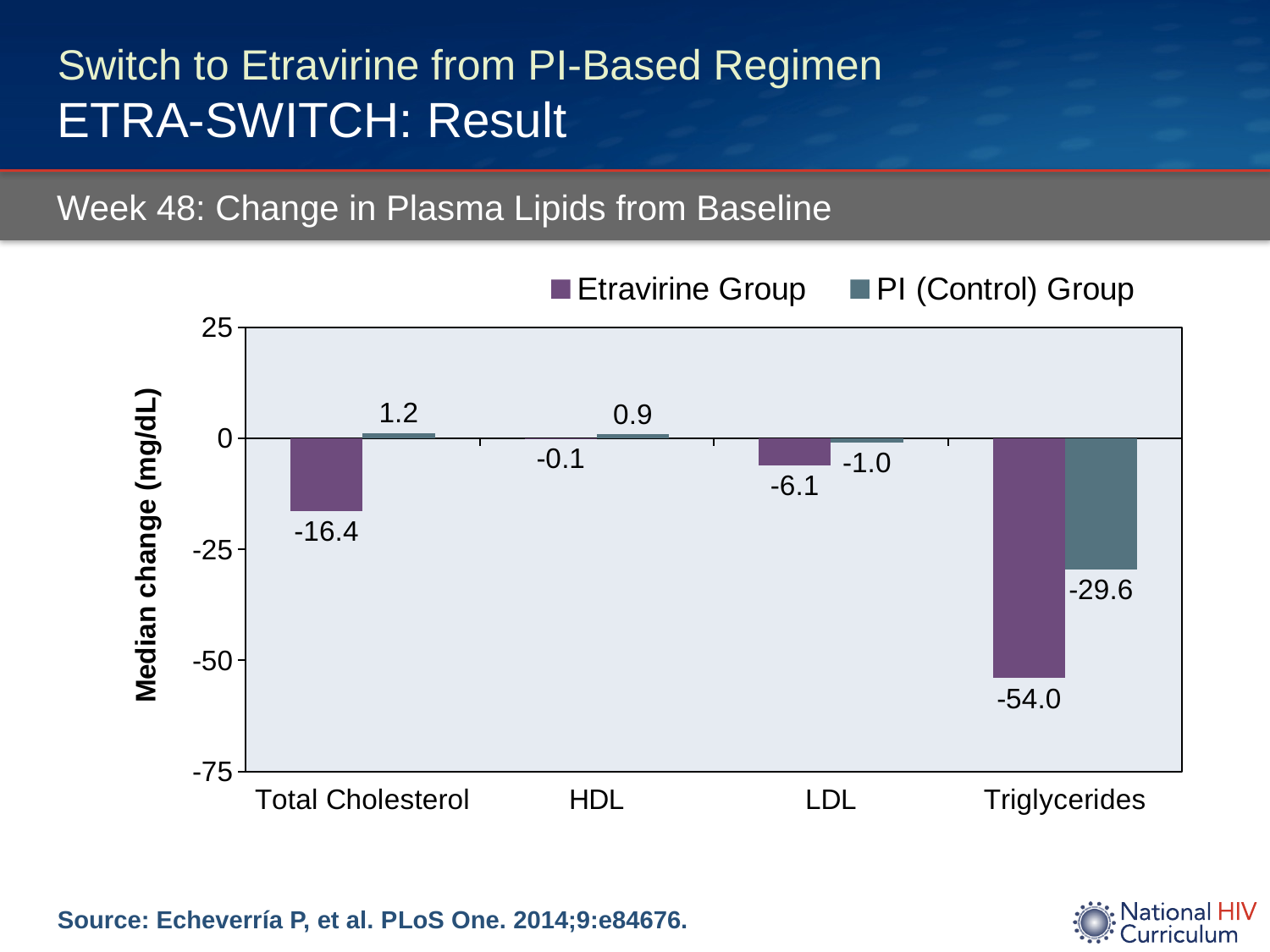
How many lipid categories are shown on the x axis? 4 What is the label of the y axis? Median change (mg/dL) What is the median change in Total Cholesterol for the Etravirine Group? -16.4 How many series does the legend list? 2 What is the median change in Triglycerides for the PI (Control) Group? -29.6 What kind of chart is shown on the slide? Bar chart What is the median change in LDL for the Etravirine Group? -6.1 What is the difference between the Etravirine Group and PI (Control) Group values for Triglycerides? 24.4 Which lipid category shows the largest decrease for the Etravirine Group? Triglycerides Is the Etravirine Group value for Triglycerides greater or less than -50? less What is the median change in HDL for the PI (Control) Group? 0.9 Which group has the larger decrease in Total Cholesterol, the Etravirine Group or the PI (Control) Group? Etravirine Group